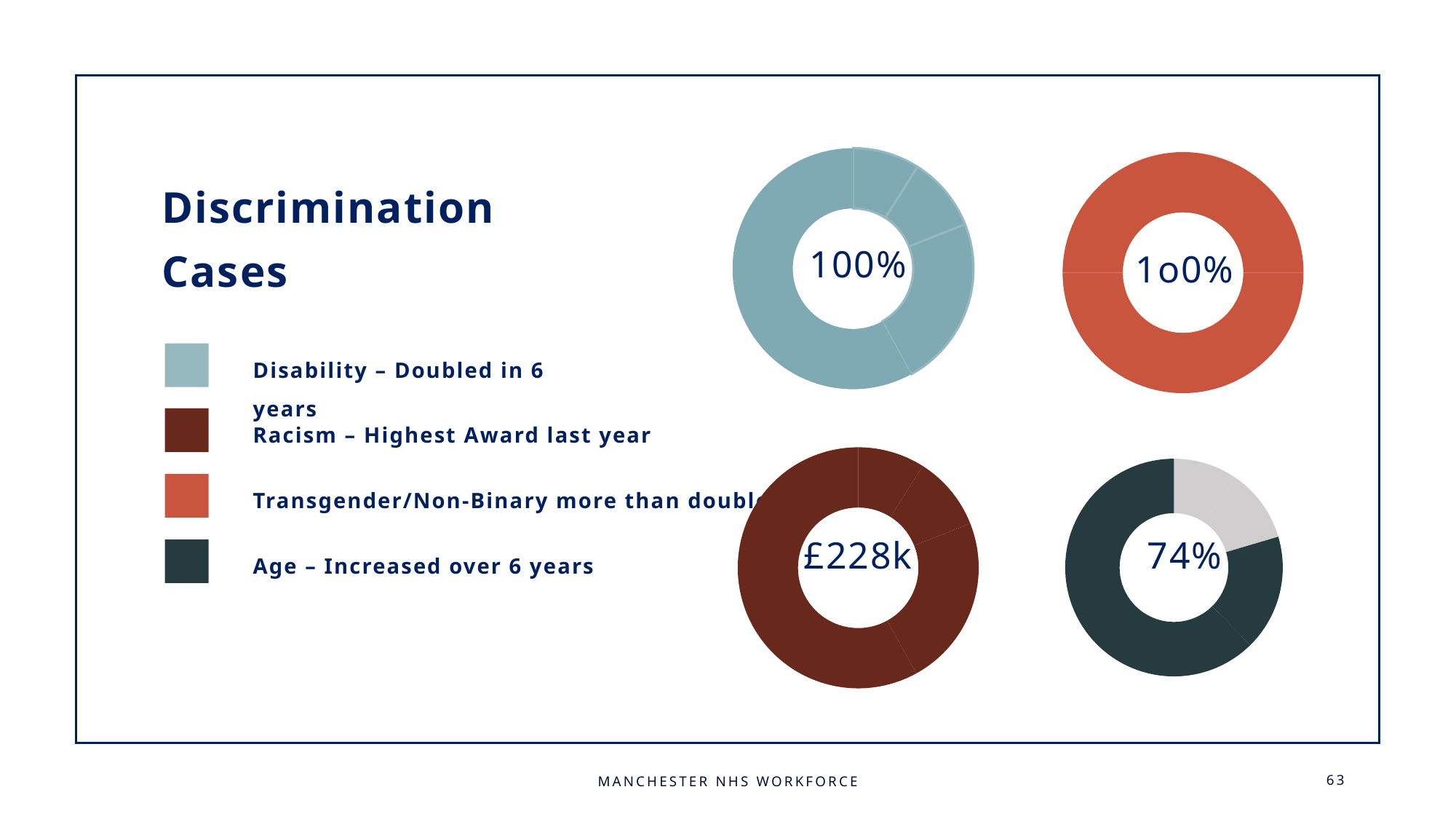
Which is larger, the value in the centre of the Disability (top-left) donut or the value in the centre of the Age (bottom-right) donut? Disability (top-left) donut What value is printed in the centre of the top-left (light blue, Disability) donut chart? 100% How many entries does the legend on the left of the slide list? 4 What value is printed in the centre of the bottom-left (dark red, Racism) donut chart? £228k Which category does the light blue colour in the legend represent? Disability – Doubled in 6 years How many donut charts are shown on the slide? 4 What is the difference between the centre value of the Disability (top-left) donut and the centre value of the Age (bottom-right) donut? 26% Is the value shown in the Age (bottom-right) donut chart greater or less than 50%? greater Which category does the dark teal colour in the legend represent? Age – Increased over 6 years What value is printed in the centre of the bottom-right (dark teal, Age) donut chart? 74% What kind of chart is used for the four charts on the right of the slide? donut chart